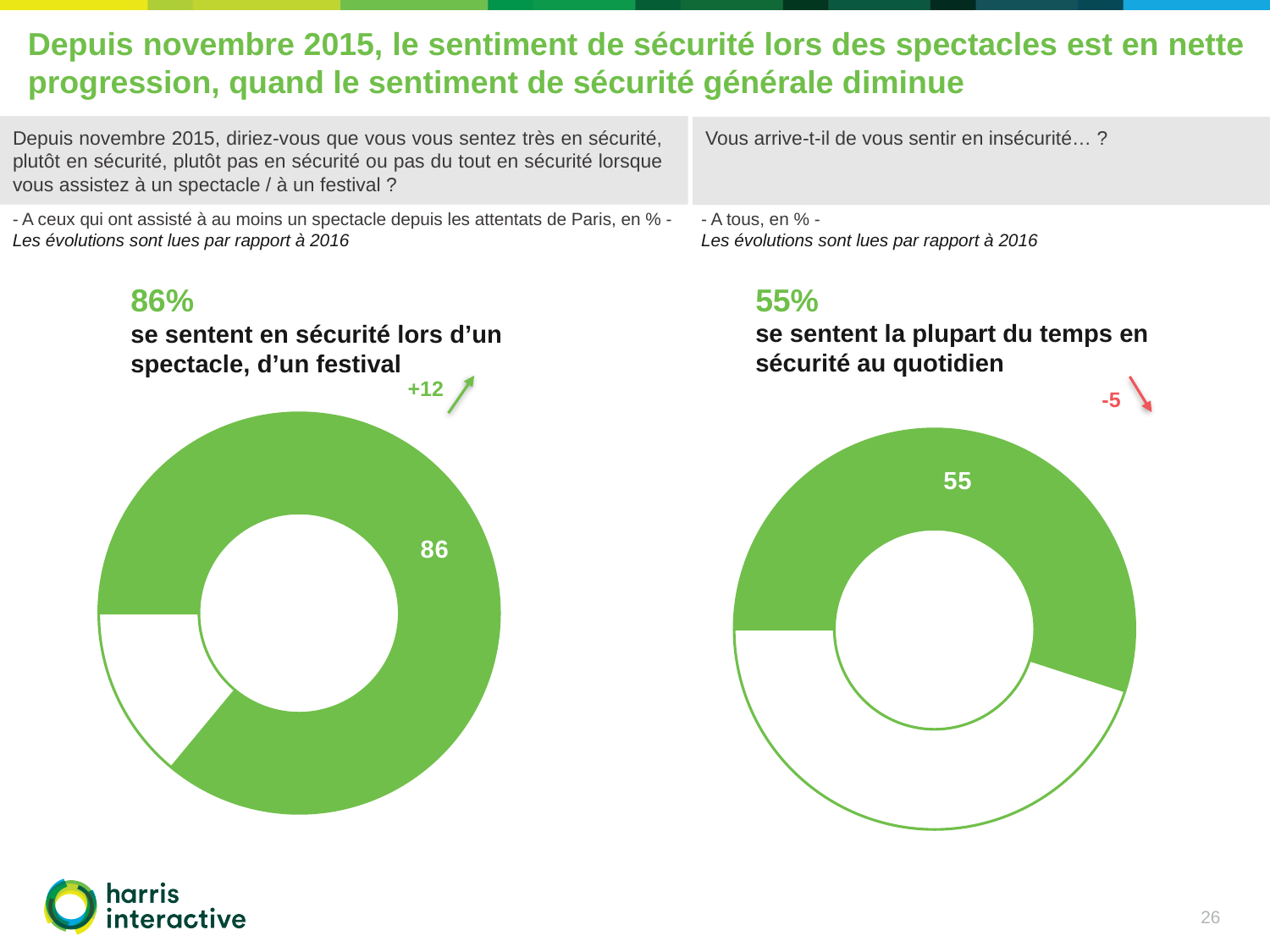
What change versus 2016 is indicated next to the right chart? -5 In the left donut chart, what value is shown on the green segment? 86 Is the green segment value in the right donut chart greater or less than 50? greater In the right donut chart, what value is shown on the green segment? 55 What change versus 2016 is indicated next to the left chart? +12 What kind of chart is used on the left side of the slide? Donut (pie) chart In the left chart, what share of the donut does the green segment represent? 86% What is the difference between the green segment value in the left chart and the green segment value in the right chart? 31 What kind of chart is used on the right side of the slide? Donut (pie) chart In the right chart, what share of the donut does the green segment represent? 55% How many donut charts are shown on the slide? 2 Which chart has the larger green segment, the left one or the right one? The left one